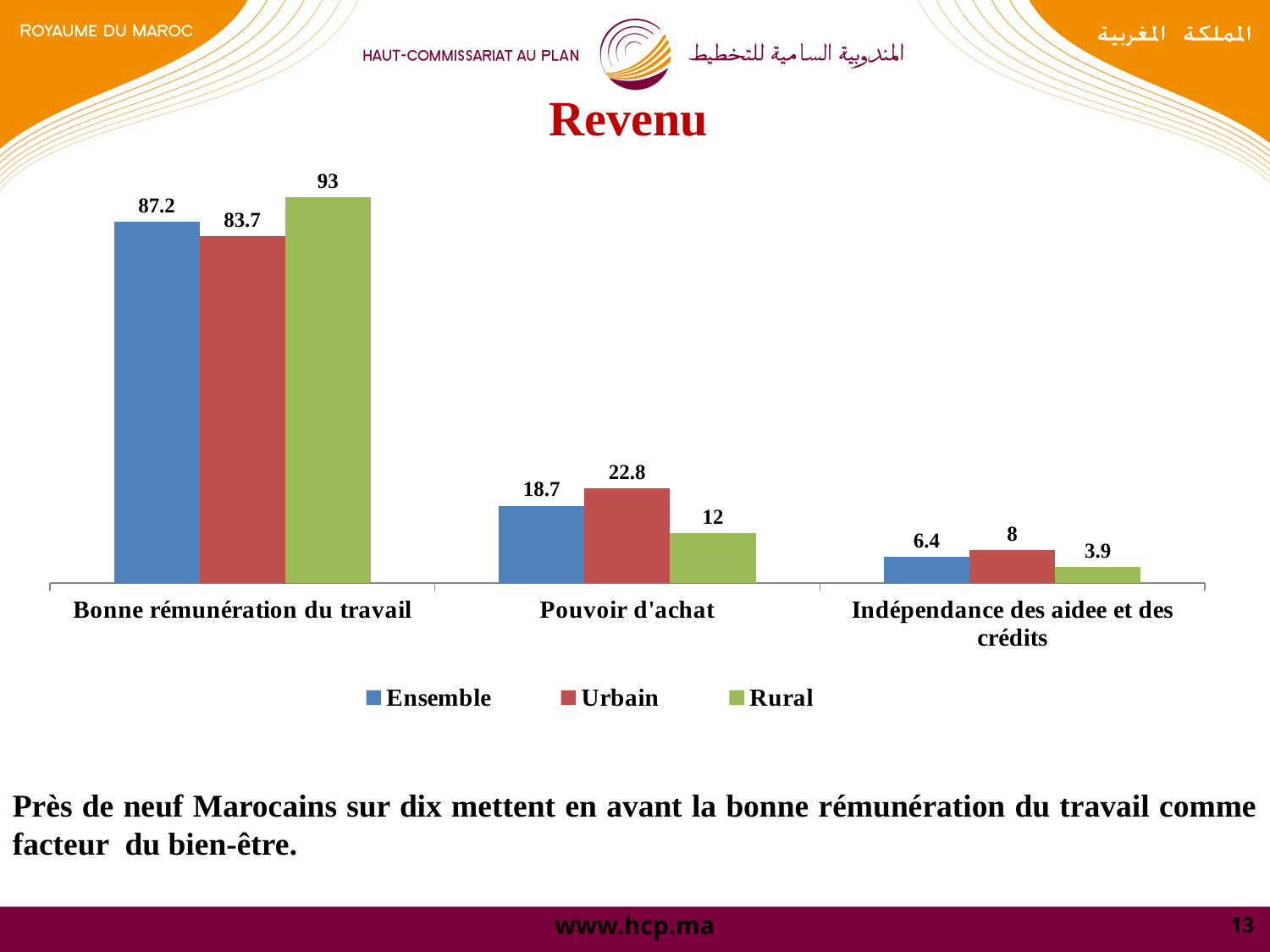
How many series does the legend list? 3 How many categories are shown on the x axis? 3 What is the Urbain value for Pouvoir d'achat? 22.8 What is the title of the chart? Revenu What is the Ensemble value for Indépendance des aidee et des crédits? 6.4 What kind of chart is shown on the slide? Bar chart Which category has the lowest Rural value? Indépendance des aidee et des crédits For Pouvoir d'achat, which is larger: the Ensemble value or the Urbain value? Urbain What is the difference between the Urbain and Rural values for Pouvoir d'achat? 10.8 What is the Rural value for Bonne rémunération du travail? 93 Which category has the highest Ensemble value? Bonne rémunération du travail What is the difference between the Rural and Urbain values for Bonne rémunération du travail? 9.3